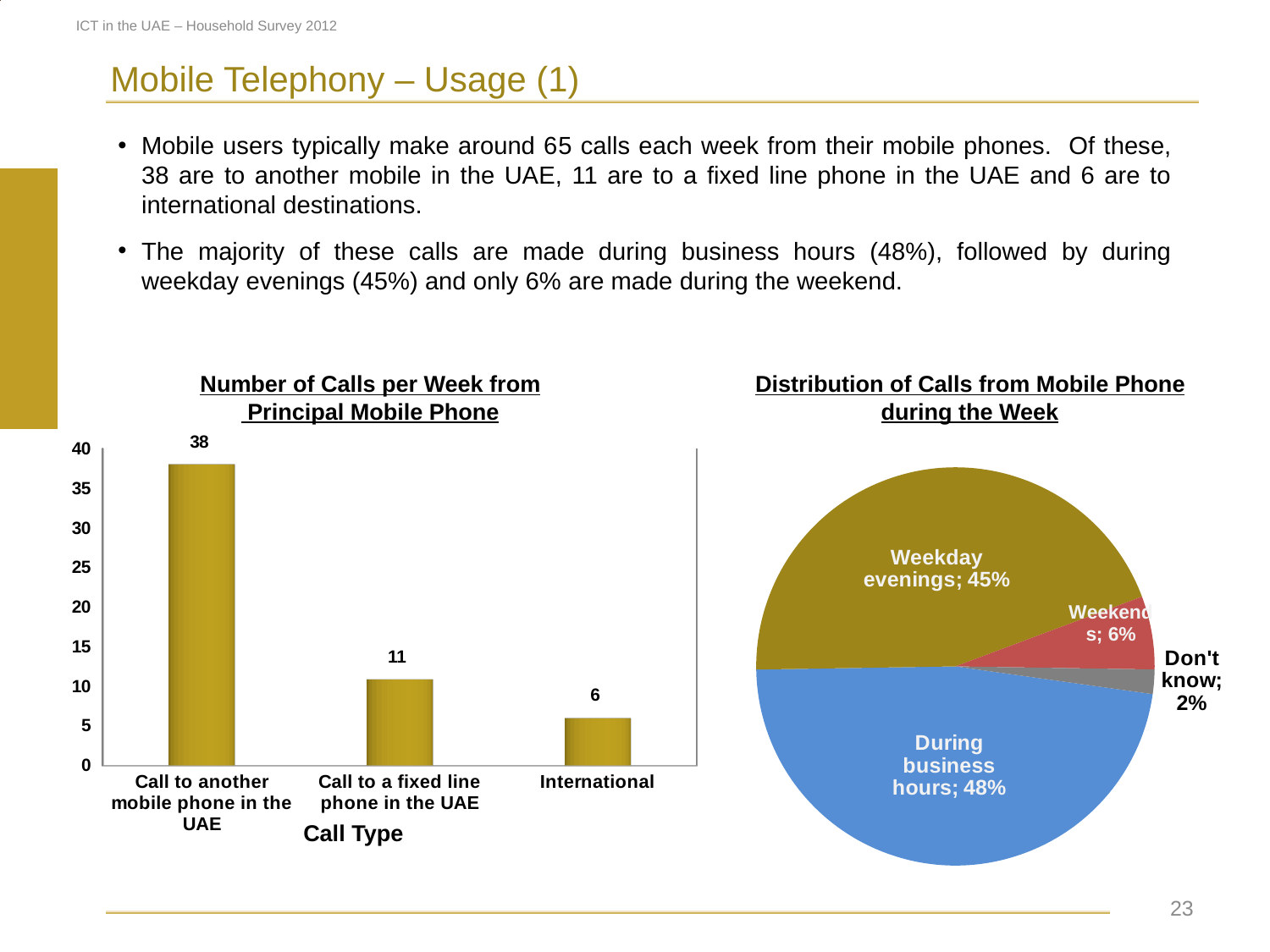
What kind of chart is 'Distribution of Calls from Mobile Phone during the Week'? Pie chart In the 'Distribution of Calls from Mobile Phone during the Week' chart, which slice is the smallest? Don't know In the 'Number of Calls per Week from Principal Mobile Phone' chart, what is the value for 'Call to another mobile phone in the UAE'? 38 What kind of chart is 'Number of Calls per Week from Principal Mobile Phone'? Bar chart In the 'Number of Calls per Week from Principal Mobile Phone' chart, what is the value for 'International'? 6 In the 'Number of Calls per Week from Principal Mobile Phone' chart, which call type has the lowest value? International In the 'Number of Calls per Week from Principal Mobile Phone' chart, what is the label of the x axis? Call Type In the 'Distribution of Calls from Mobile Phone during the Week' chart, what share of calls is made during business hours? 48% In the 'Number of Calls per Week from Principal Mobile Phone' chart, what is the difference between 'Call to another mobile phone in the UAE' and 'Call to a fixed line phone in the UAE'? 27 In the 'Number of Calls per Week from Principal Mobile Phone' chart, which call type has the highest value? Call to another mobile phone in the UAE In the 'Distribution of Calls from Mobile Phone during the Week' chart, what share of calls is made on weekends? 6% In the 'Number of Calls per Week from Principal Mobile Phone' chart, how many call types are shown? 3